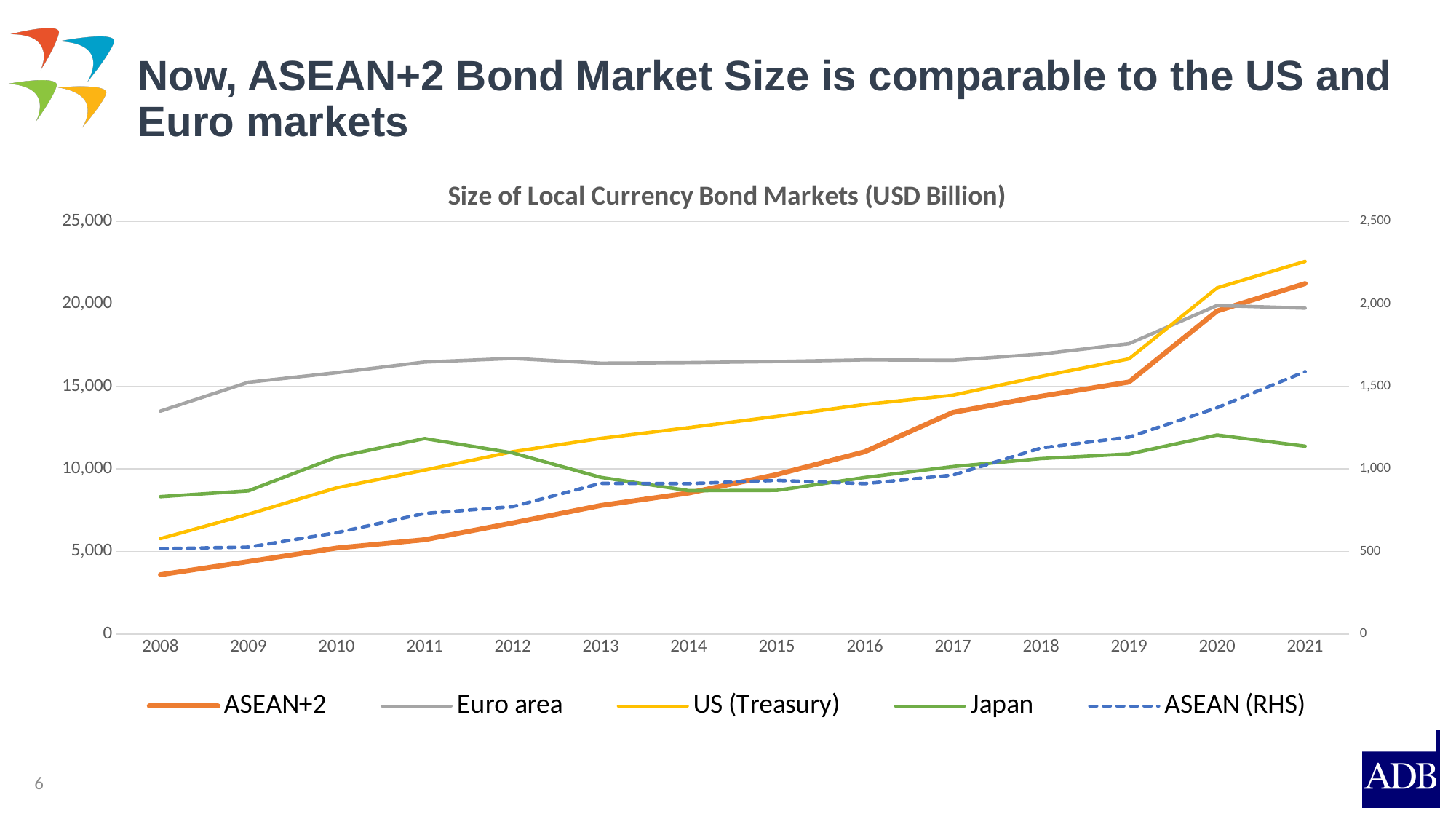
What kind of chart is shown on the slide? line chart Is the value for ASEAN+2 in 2008 greater or less than 5,000? less Is the value for US (Treasury) in 2021 greater or less than 20,000? greater How many series does the legend list? 5 Is the value for Japan in 2011 greater or less than 10,000? greater What is the title of the chart? Size of Local Currency Bond Markets (USD Billion) Which series is plotted on the right-hand axis? ASEAN (RHS) How many years are shown along the x axis? 14 In 2021, which is larger: US (Treasury) or Euro area? US (Treasury) Which series has the highest value in 2008? Euro area Does the ASEAN+2 line rise or fall from 2008 to 2021? rise